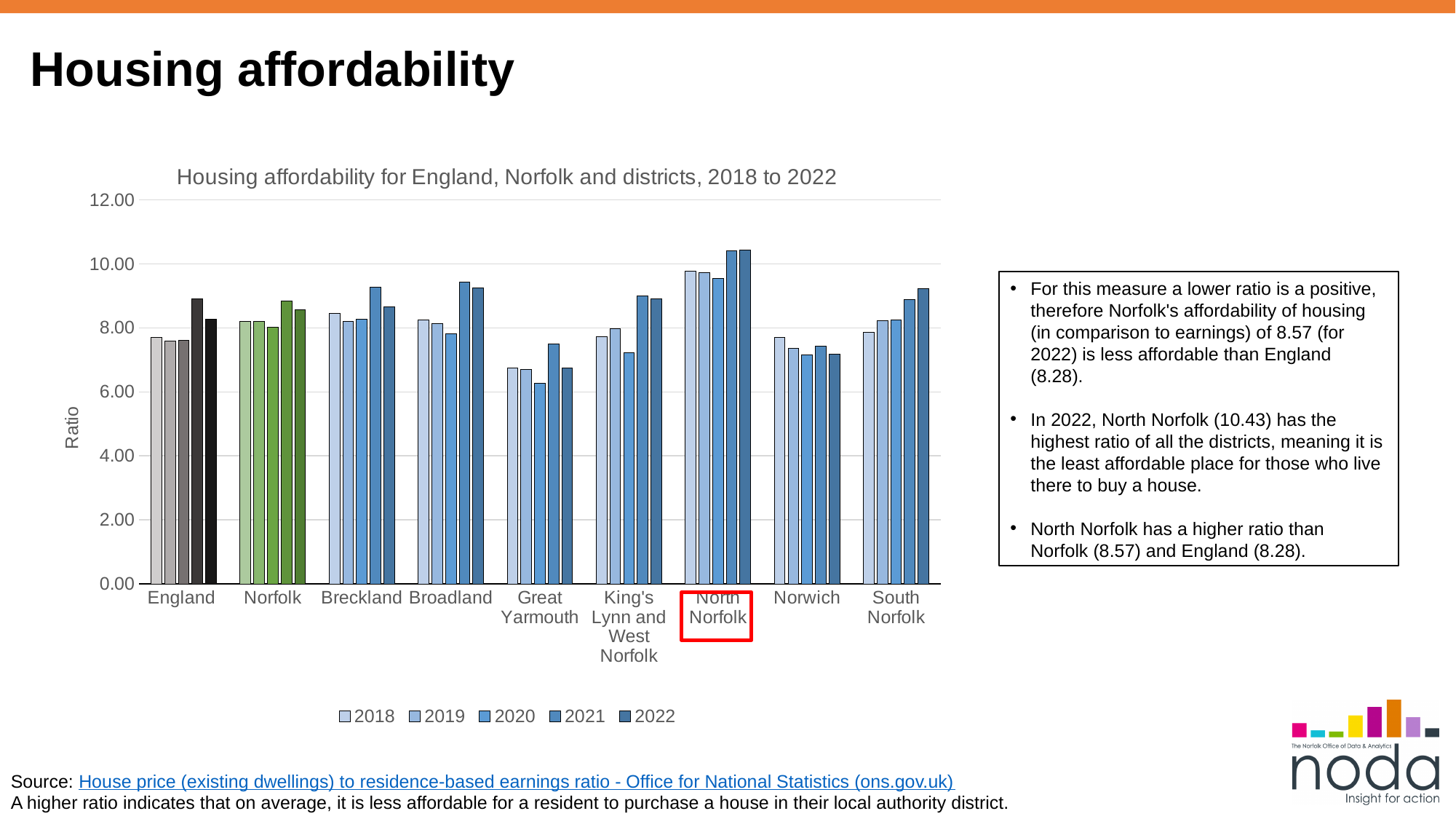
How many areas (categories) are shown along the x axis of the chart? 9 How many series does the chart legend list? 5 What is the difference between North Norfolk's 2022 ratio (10.43) and Norfolk's 2022 ratio (8.57)? 1.86 According to the slide, what is England's housing affordability ratio for 2022? 8.28 What kind of chart is shown on the slide? Bar chart What is the title of the chart? Housing affordability for England, Norfolk and districts, 2018 to 2022 Is the value for North Norfolk in 2021 greater or less than 10.00? greater Which district has the highest ratio in 2022? North Norfolk Which is larger, the 2021 value for Breckland or the 2021 value for Norwich? Breckland According to the slide, what is Norfolk's housing affordability ratio for 2022? 8.57 Which area has the lowest ratio in 2020? Great Yarmouth According to the slide, what is North Norfolk's housing affordability ratio for 2022? 10.43